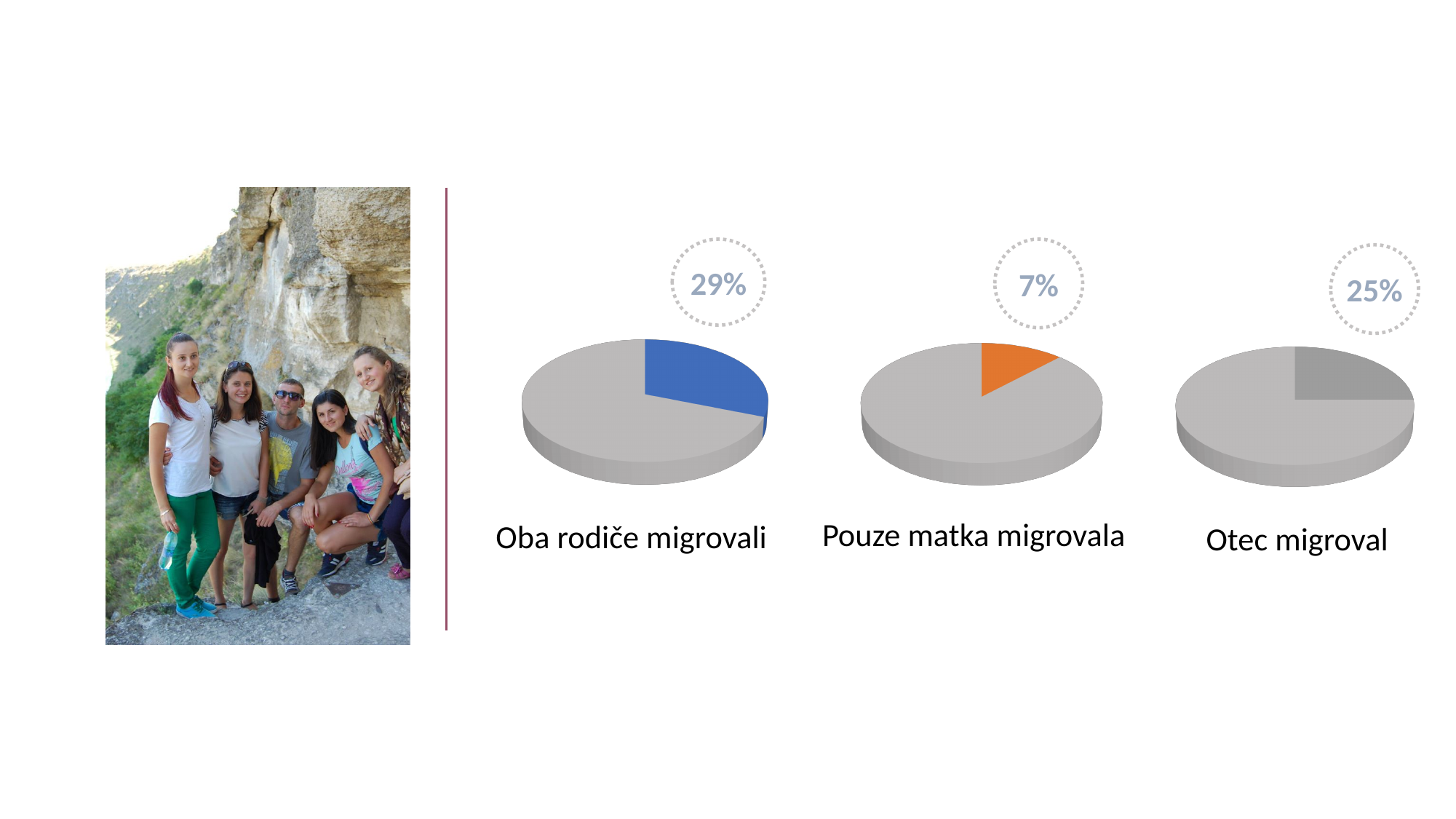
What percentage is shown for the 'Oba rodiče migrovali' pie chart? 29% What is the difference between the percentage for 'Oba rodiče migrovali' and the percentage for 'Otec migroval'? 4% Which of the three pie charts shows the lowest percentage? Pouze matka migrovala How many pie charts are shown on the slide? 3 What colour is the highlighted slice in the 'Oba rodiče migrovali' pie chart? Blue What colour is the highlighted slice in the 'Pouze matka migrovala' pie chart? Orange What is the difference between the percentage for 'Otec migroval' and the percentage for 'Pouze matka migrovala'? 18% Which is larger, the percentage for 'Oba rodiče migrovali' or the percentage for 'Pouze matka migrovala'? Oba rodiče migrovali Which of the three pie charts shows the highest percentage? Oba rodiče migrovali What kind of chart is used for 'Otec migroval'? Pie chart What percentage is shown for the 'Otec migroval' pie chart? 25% What percentage is shown for the 'Pouze matka migrovala' pie chart? 7%